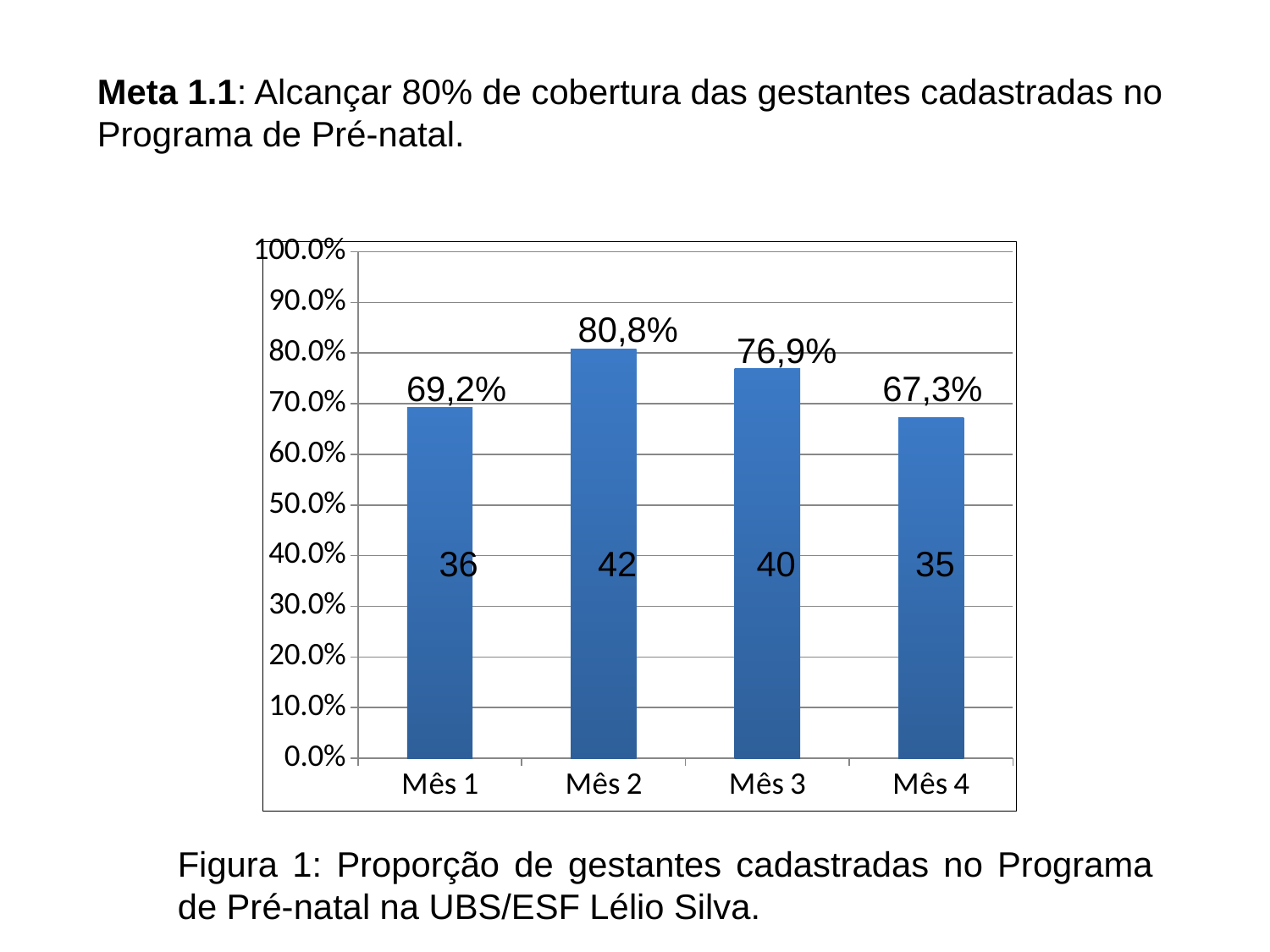
Which is larger, the percentage for Mês 1 or for Mês 3? Mês 3 What count is printed inside the bar for Mês 1? 36 How many months are shown on the x axis? 4 Which month has the lowest percentage? Mês 4 What kind of chart is shown on the slide? bar chart What is the percentage value shown for Mês 4? 67,3% Which month has the highest percentage? Mês 2 What count is printed inside the bar for Mês 3? 40 Is the value for Mês 3 greater or less than 80.0%? less What is the difference in percentage points between Mês 2 and Mês 4? 13,5 What is the figure caption below the chart? Figura 1: Proporção de gestantes cadastradas no Programa de Pré-natal na UBS/ESF Lélio Silva. What is the percentage value shown for Mês 2? 80,8%